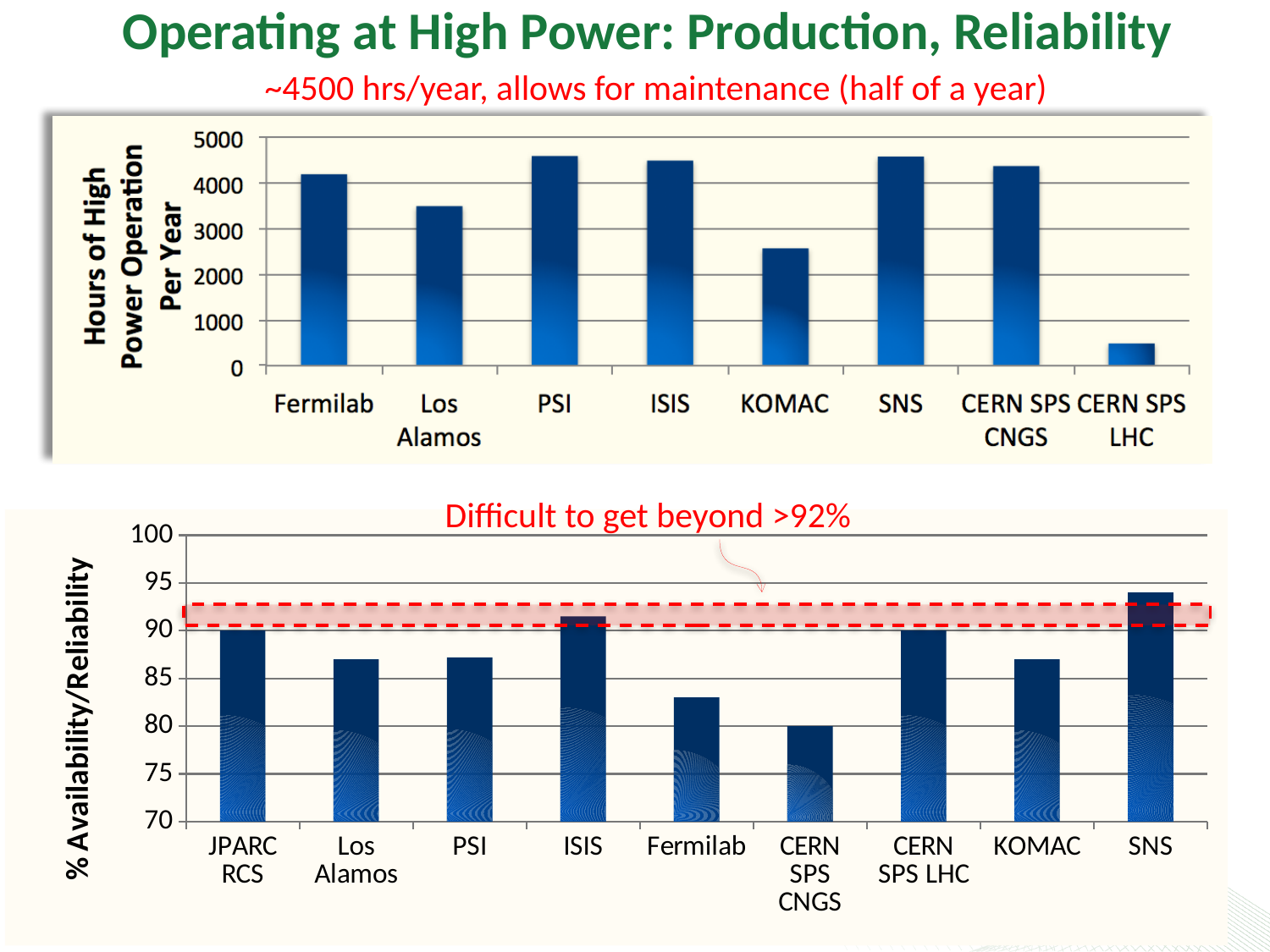
What kind of chart is the bottom chart (% Availability/Reliability)? bar chart In the top chart (Hours of High Power Operation Per Year), which is larger, Fermilab or Los Alamos? Fermilab In the top chart (Hours of High Power Operation Per Year), is the value for KOMAC greater or less than 3000? less How many facilities are shown in the top chart (Hours of High Power Operation Per Year)? 8 In the top chart (Hours of High Power Operation Per Year), is the value for CERN SPS LHC greater or less than 1000? less In the bottom chart (% Availability/Reliability), which is larger, ISIS or PSI? ISIS How many facilities are shown in the bottom chart (% Availability/Reliability)? 9 In the bottom chart (% Availability/Reliability), is the value for Fermilab greater or less than 85? less In the bottom chart (% Availability/Reliability), which facility has the lowest value? CERN SPS CNGS In the top chart (Hours of High Power Operation Per Year), which facility has the lowest value? CERN SPS LHC In the bottom chart (% Availability/Reliability), which facility has the highest value? SNS